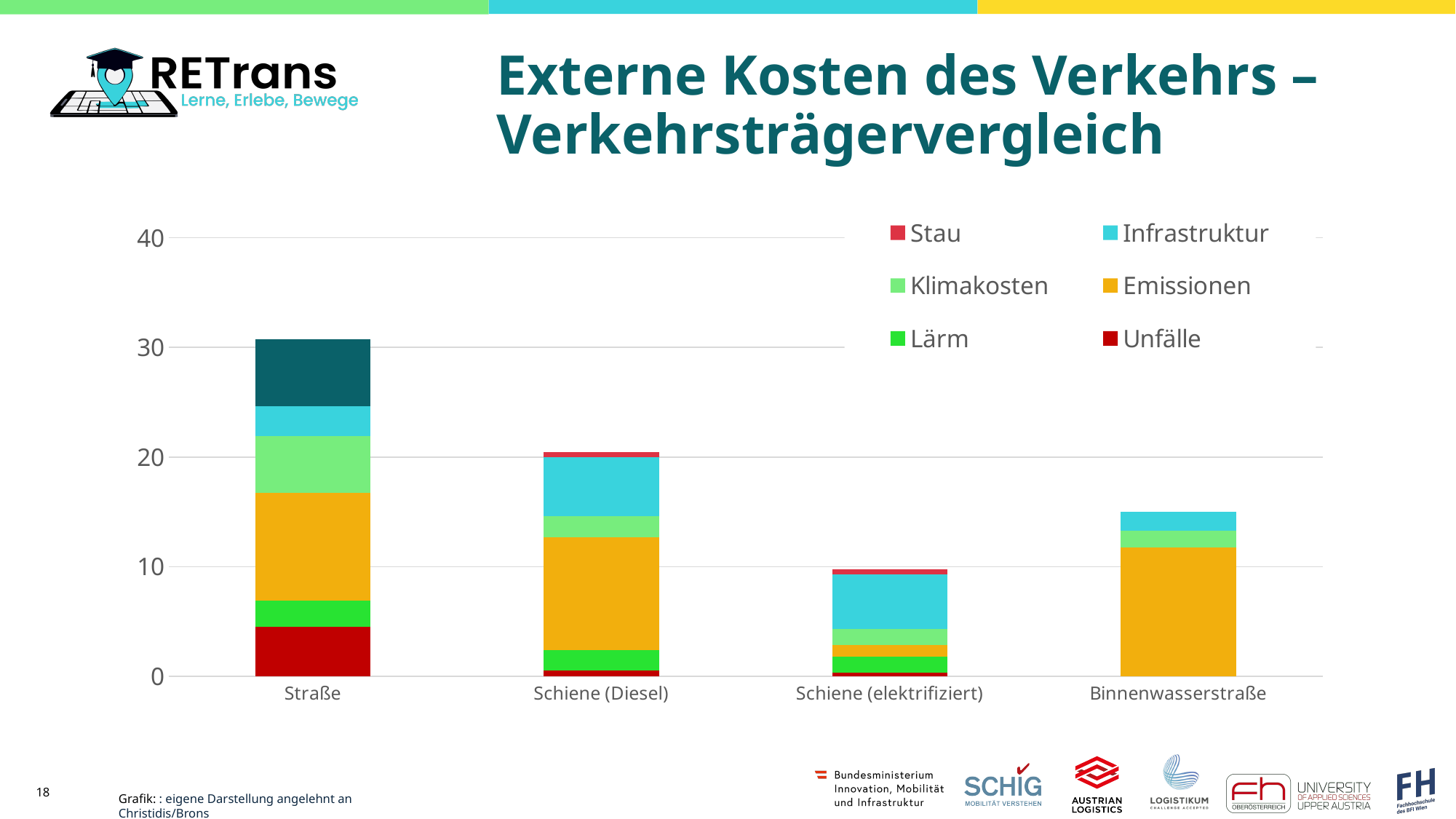
What kind of chart is shown on the slide? Stacked bar chart How many categories are shown on the x axis of the chart? 4 Which has the larger total bar, Schiene (Diesel) or Binnenwasserstraße? Schiene (Diesel) Which category has the highest total bar in the chart? Straße What is the title of the slide containing the chart? Externe Kosten des Verkehrs – Verkehrsträgervergleich Which series in the legend is shown in orange? Emissionen Which category has the lowest total bar in the chart? Schiene (elektrifiziert) How many series does the chart's legend list? 6 Is the total value for Binnenwasserstraße greater or less than 10? greater Is the total value for Straße greater or less than 20? greater Is the total value for Binnenwasserstraße greater or less than 20? less